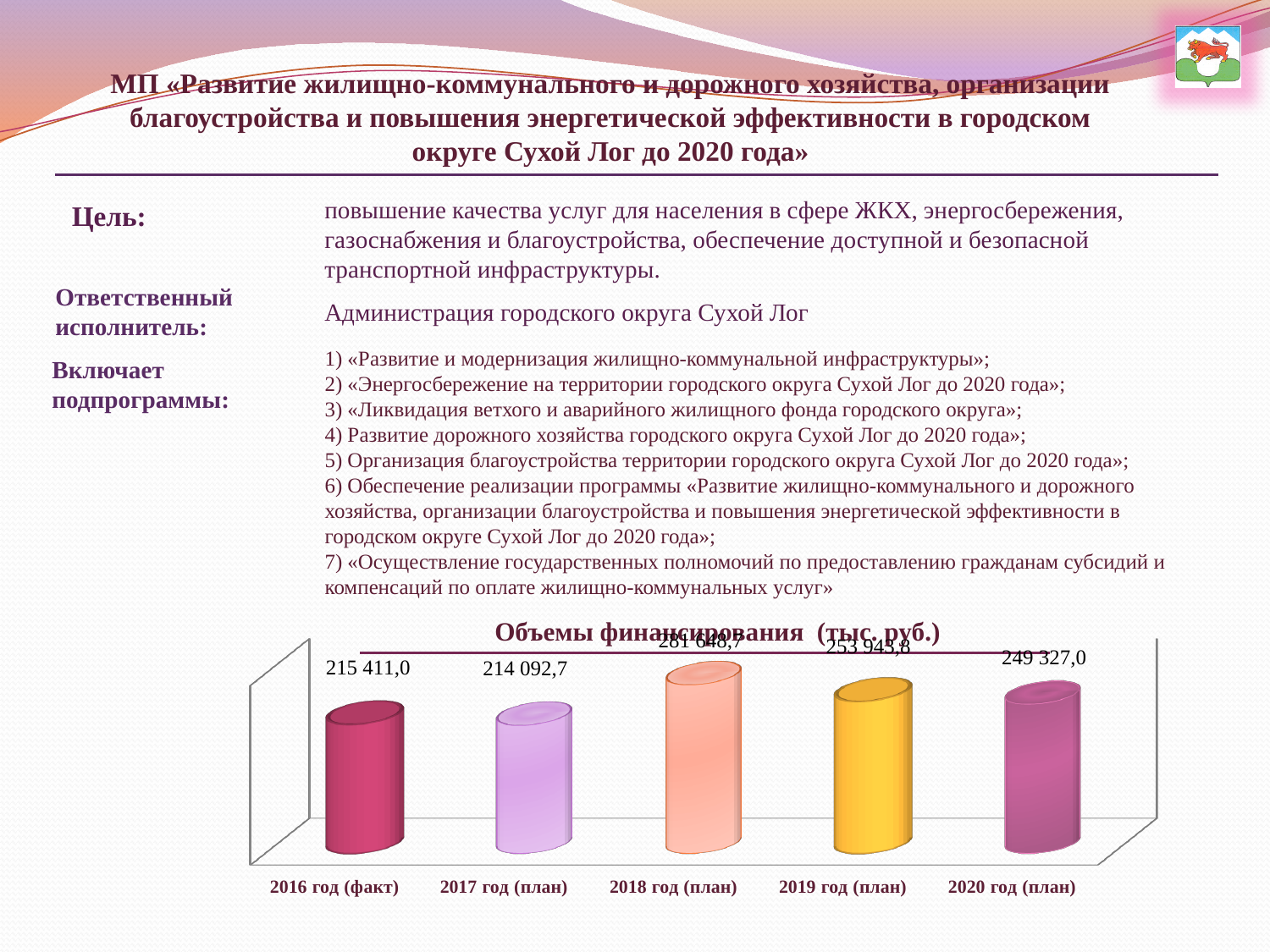
What is the value for 2018 год (план)? 281 648,7 What is the value for 2020 год (план)? 249 327,0 What is the value for 2016 год (факт)? 215 411,0 Which category has the highest value? 2018 год (план) What is the difference between the values for 2018 год (план) and 2019 год (план)? 27 704,9 What kind of chart is shown on the slide? bar chart Do the values rise or fall from 2018 год (план) to 2020 год (план)? fall What is the title of the chart on the slide? Объемы финансирования (тыс. руб.) Which is larger, the value for 2019 год (план) or 2020 год (план)? 2019 год (план) Which category has the lowest value? 2017 год (план) What is the value for 2017 год (план)? 214 092,7 How many categories are plotted in the chart? 5